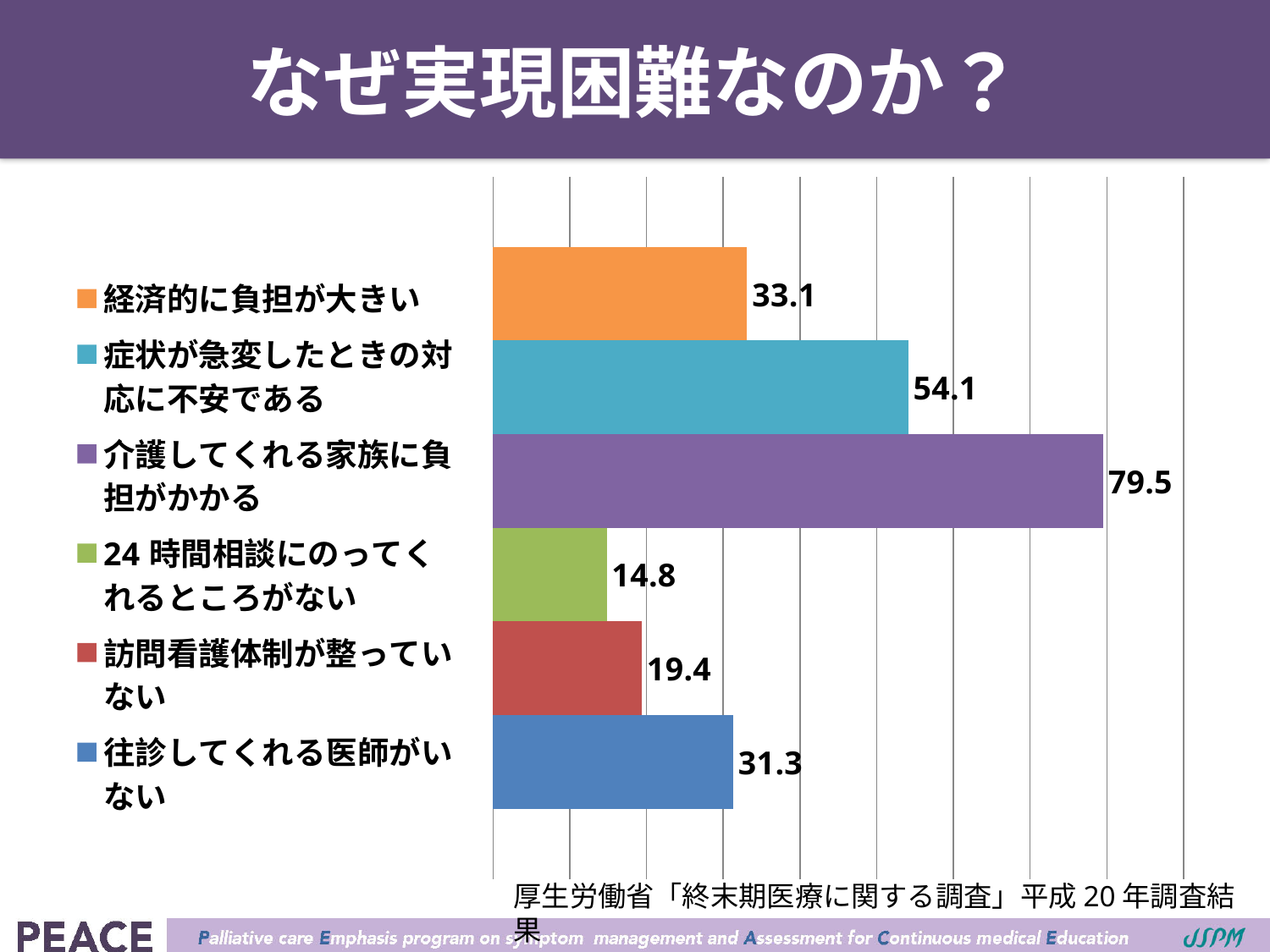
Which is larger, the value for 訪問看護体制が整っていない or the value for 往診してくれる医師がいない? 往診してくれる医師がいない What is the value for 経済的に負担が大きい? 33.1 What is the difference between the values for 介護してくれる家族に負担がかかる and 症状が急変したときの対応に不安である? 25.4 What is the value for 24時間相談にのってくれるところがない? 14.8 What kind of chart is shown on the slide? Bar chart How many entries does the legend list? 6 How many bars are plotted in the chart? 6 What is the value for 介護してくれる家族に負担がかかる? 79.5 Which category has the highest value? 介護してくれる家族に負担がかかる What is the value for 往診してくれる医師がいない? 31.3 Which category has the lowest value? 24時間相談にのってくれるところがない What is the value for 症状が急変したときの対応に不安である? 54.1